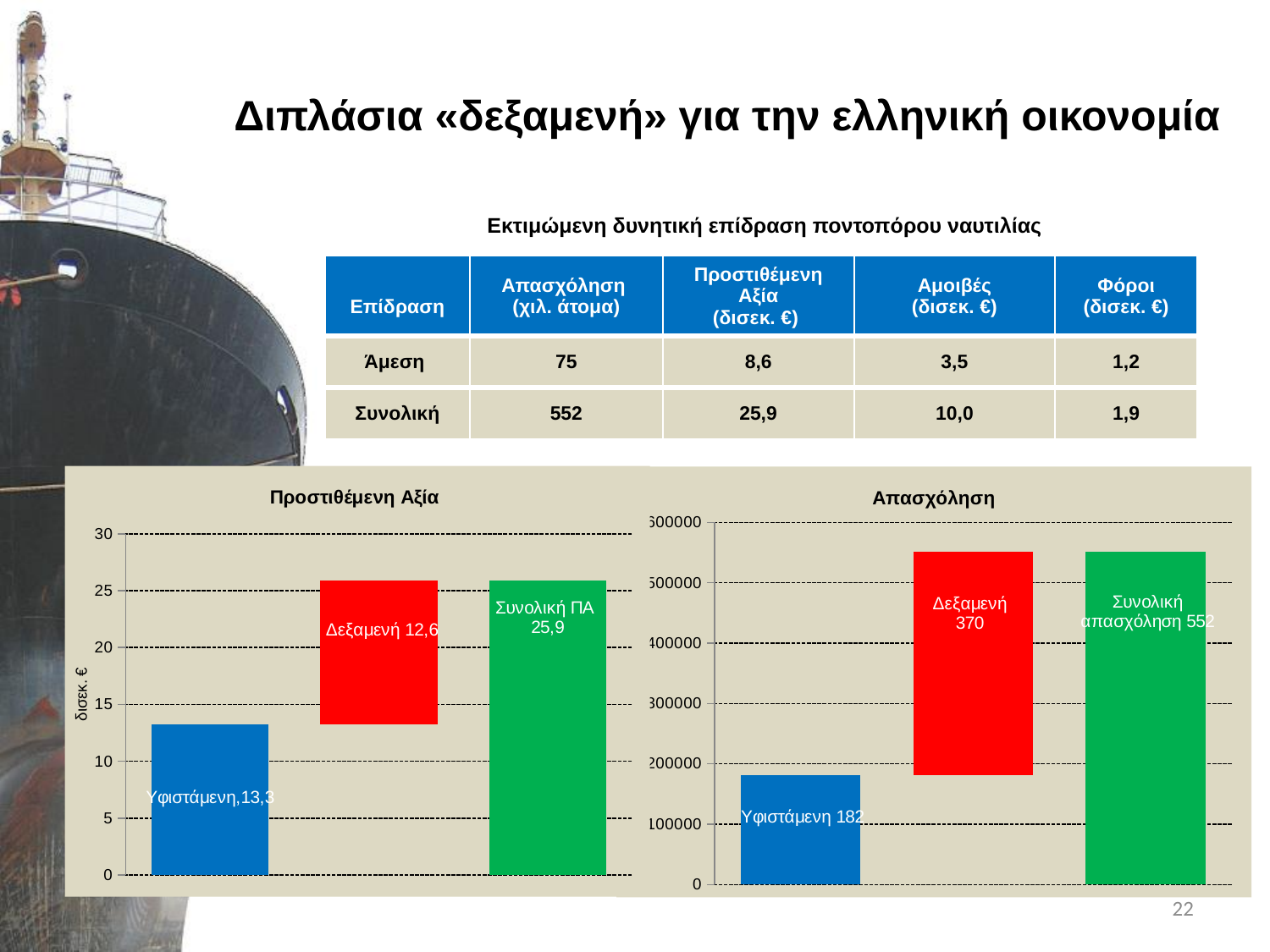
In the chart titled Προστιθέμενη Αξία, what value is labelled on the Υφιστάμενη bar? 13,3 In the chart titled Προστιθέμενη Αξία, which is larger, the Υφιστάμενη value or the Δεξαμενή value? Υφιστάμενη In the chart titled Προστιθέμενη Αξία, what value is labelled on the Δεξαμενή bar? 12,6 What kind of chart is the chart titled Απασχόληση? Bar chart In the chart titled Απασχόληση, what value is labelled on the Συνολική απασχόληση bar? 552 In the chart titled Απασχόληση, what value is labelled on the Δεξαμενή bar? 370 In the chart titled Προστιθέμενη Αξία, what value is labelled on the Συνολική ΠΑ bar? 25,9 How many bars are shown in the chart titled Προστιθέμενη Αξία? 3 In the chart titled Προστιθέμενη Αξία, what is the difference between the Συνολική ΠΑ value and the Υφιστάμενη value? 12,6 In the chart titled Απασχόληση, what is the difference between the Συνολική απασχόληση value and the Υφιστάμενη value? 370 In the chart titled Απασχόληση, what value is labelled on the Υφιστάμενη bar? 182 What is the label on the vertical axis of the chart titled Προστιθέμενη Αξία? δισεκ. €